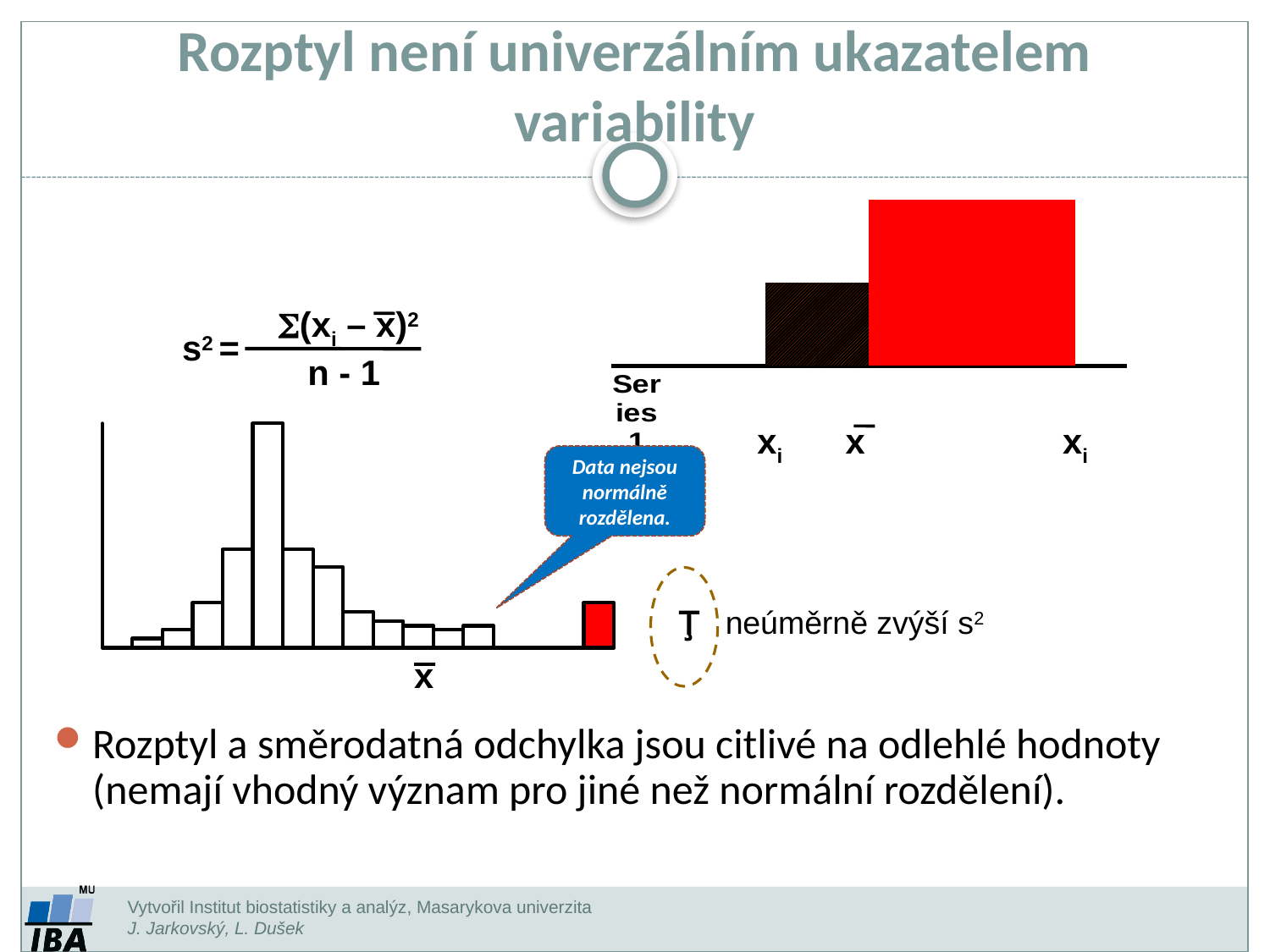
In the top-right chart, which bar is taller, the black hatched bar or the red bar? the red bar In the top-right chart, what legend entry is shown below the axis? Series 1 What kind of chart is shown in the top right of the slide? bar chart In the top-right chart, what colour is the taller bar? red In the bottom-left histogram-style chart, what colour is the isolated outlier bar on the far right? red In the bottom-left chart, do the bar heights rise or fall moving from the tallest bar toward the right end of the white bars? fall What kind of chart is shown in the bottom left of the slide? bar chart In the bottom-left chart, is the tallest bar located near the x̄ mark or at the far right? near the x̄ mark In the top-right chart, how many bars are plotted? 2 In the bottom-left chart, which is taller, the red outlier bar or the tallest white bar? the tallest white bar